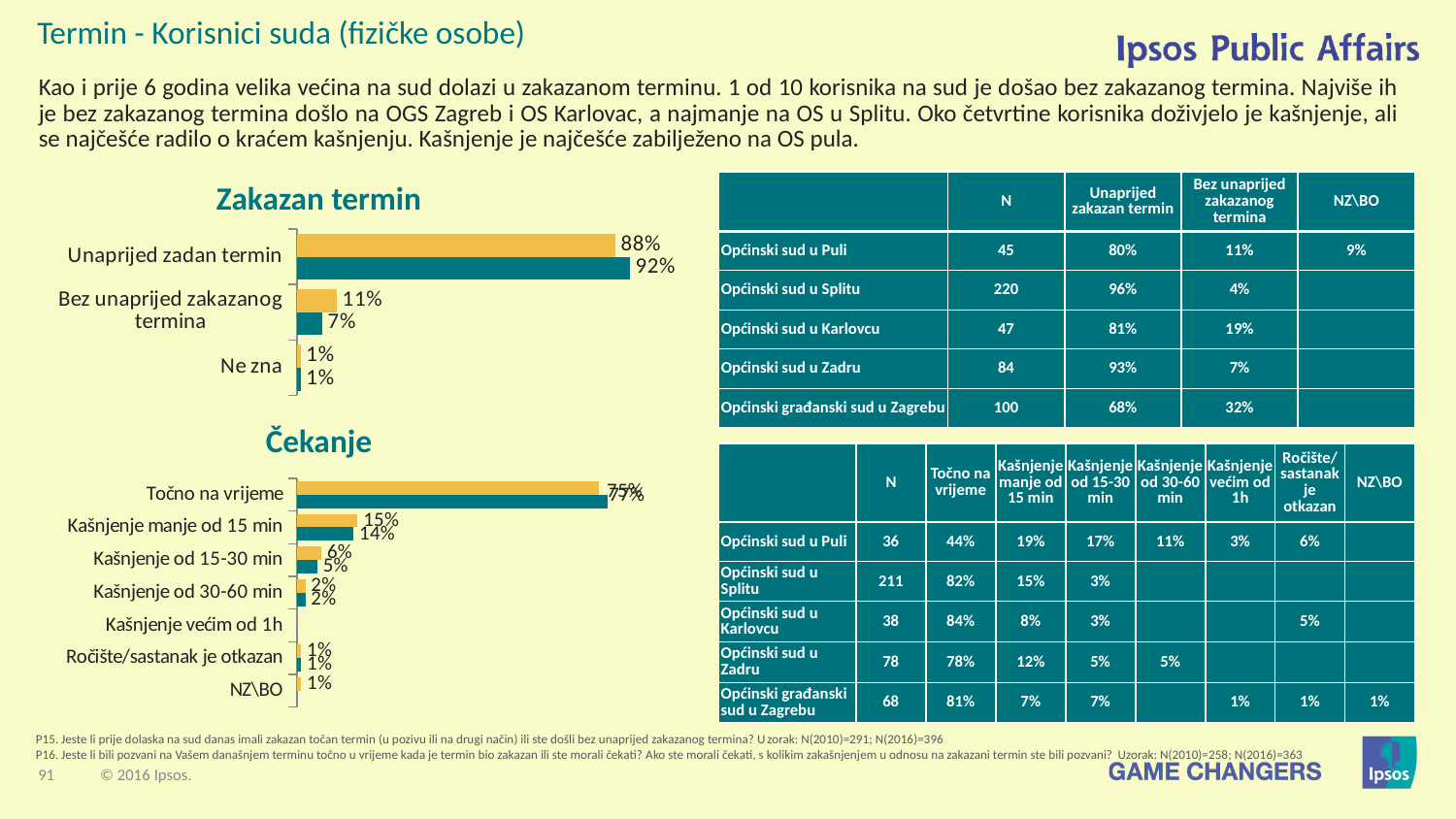
In the 'Čekanje' chart, which category has the highest values? Točno na vrijeme In the 'Zakazan termin' chart, what is the value of the yellow bar for 'Unaprijed zadan termin'? 88% In the 'Zakazan termin' chart, what is the value of the teal bar for 'Unaprijed zadan termin'? 92% How many categories are shown in the 'Čekanje' chart? 7 In the 'Čekanje' chart, what is the value of the teal bar for 'Kašnjenje od 15-30 min'? 5% How many categories are shown in the 'Zakazan termin' chart? 3 In the 'Čekanje' chart, what is the value of the yellow bar for 'Kašnjenje manje od 15 min'? 15% In the 'Zakazan termin' chart, what is the difference between the yellow and teal bars for 'Bez unaprijed zakazanog termina'? 4 percentage points In the 'Zakazan termin' chart, what is the value of the yellow bar for 'Bez unaprijed zakazanog termina'? 11% What type of chart is the 'Čekanje' chart? Bar chart In the 'Zakazan termin' chart, which category has the highest values? Unaprijed zadan termin In the 'Zakazan termin' chart, which category has the lowest values? Ne zna